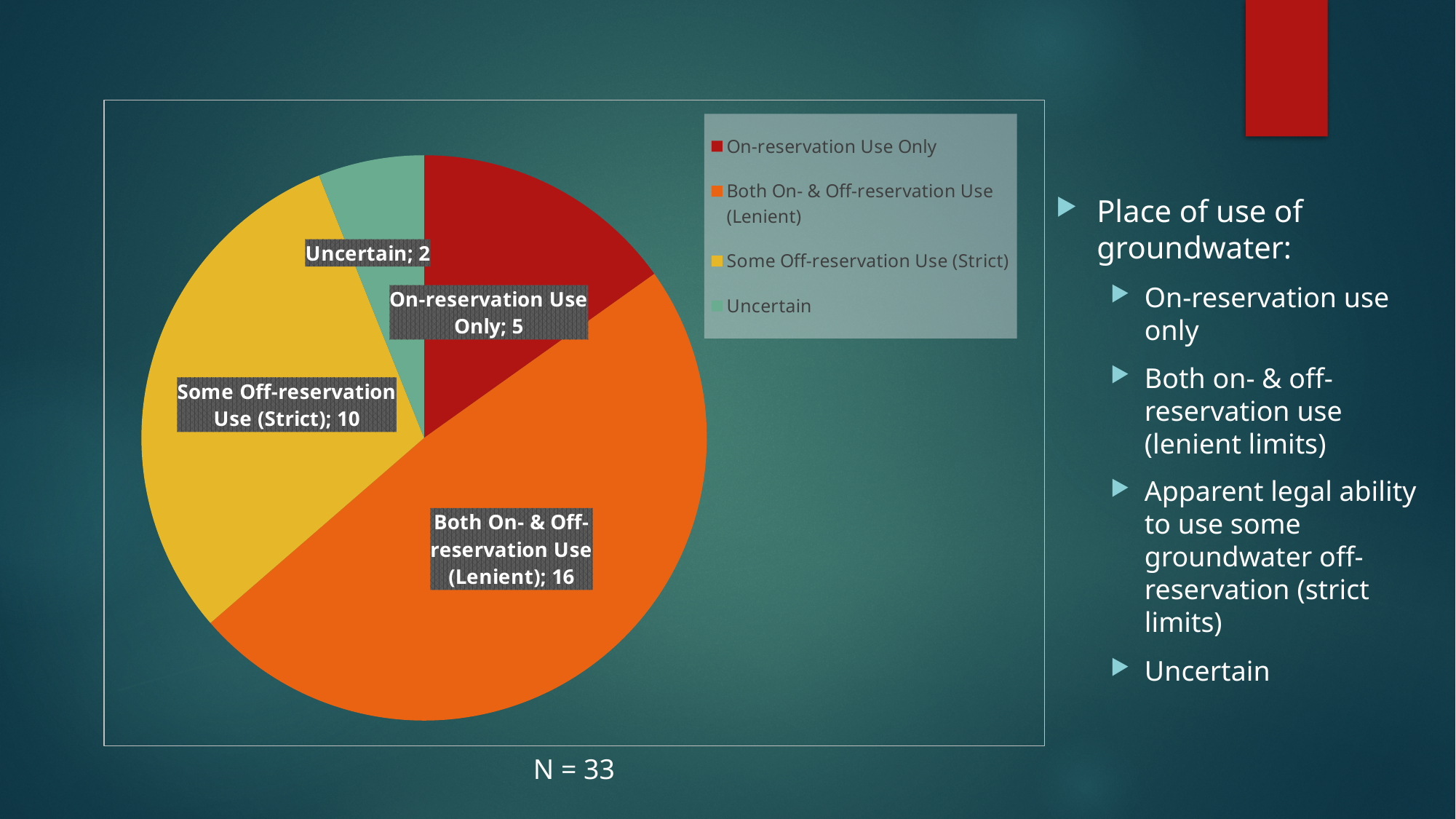
Which category has the largest slice? Both On- & Off-reservation Use (Lenient) What is the value for Both On- & Off-reservation Use (Lenient)? 16 What is the value for Some Off-reservation Use (Strict)? 10 What is the difference between the values for Both On- & Off-reservation Use (Lenient) and Some Off-reservation Use (Strict)? 6 What colour is the slice for Some Off-reservation Use (Strict)? yellow What is the total of all slices in the pie chart? 33 Which category has the smallest slice? Uncertain What is the value for On-reservation Use Only? 5 How many categories does the pie chart have? 4 What kind of chart is shown on the slide? pie chart Which is larger, the value for On-reservation Use Only or the value for Uncertain? On-reservation Use Only What is the value for Uncertain? 2